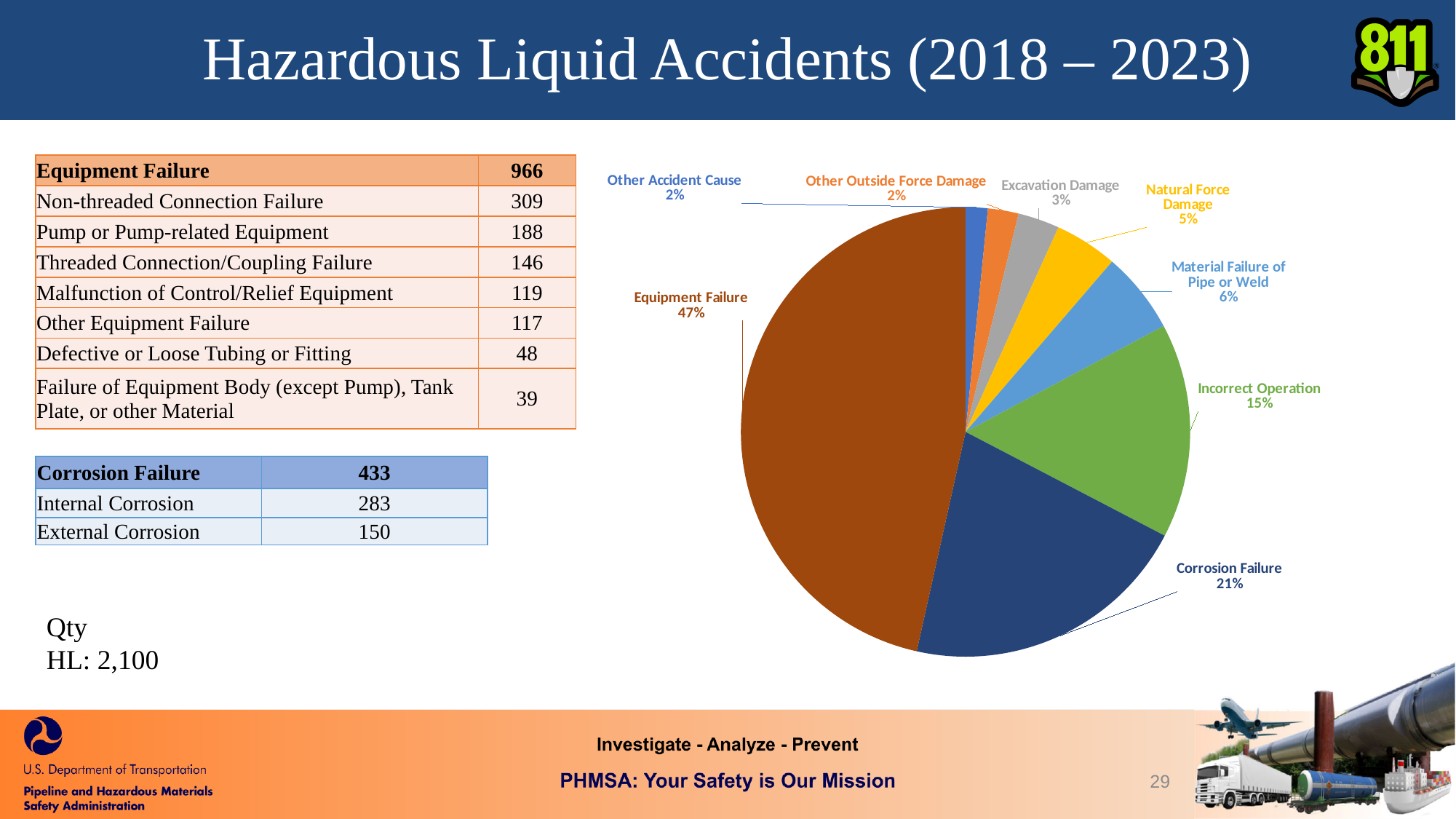
What percentage is shown for Natural Force Damage in the pie chart? 5% What share of the pie does Equipment Failure account for? 47% Which category has the largest slice in the pie chart? Equipment Failure What share of the pie does Corrosion Failure account for? 21% What percentage is shown for Incorrect Operation in the pie chart? 15% What percentage is shown for Material Failure of Pipe or Weld in the pie chart? 6% How many slices does the pie chart have? 8 What type of chart is shown on the slide? pie chart What percentage is shown for Excavation Damage in the pie chart? 3% Which is larger in the pie chart, Incorrect Operation or Material Failure of Pipe or Weld? Incorrect Operation What is the difference in percentage points between Equipment Failure and Corrosion Failure in the pie chart? 26 What colour is the Corrosion Failure slice in the pie chart? dark blue